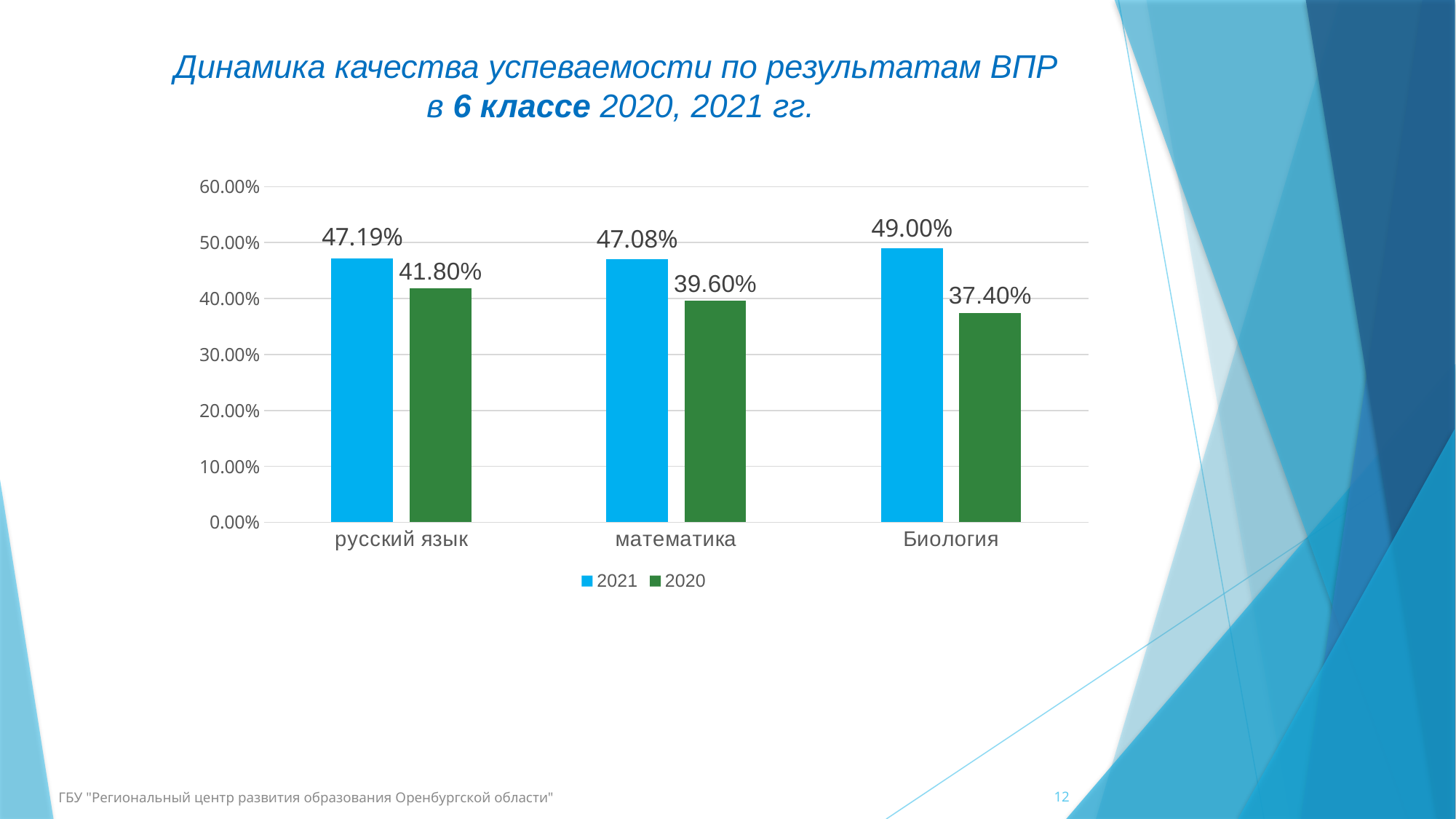
How many series does the legend list? 2 What is the difference between the 2021 and 2020 values for Биология? 11.60% What is the difference between the 2021 and 2020 values for математика? 7.48% What is the 2021 value for русский язык? 47.19% Which colour represents the 2020 series? green What is the 2020 value for математика? 39.60% Which subject has the highest 2021 value? Биология Which subject has the lowest 2020 value? Биология What kind of chart is shown on the slide? bar chart How many subjects are shown on the x axis? 3 Which is larger for русский язык: the 2021 value or the 2020 value? 2021 What is the 2020 value for Биология? 37.40%